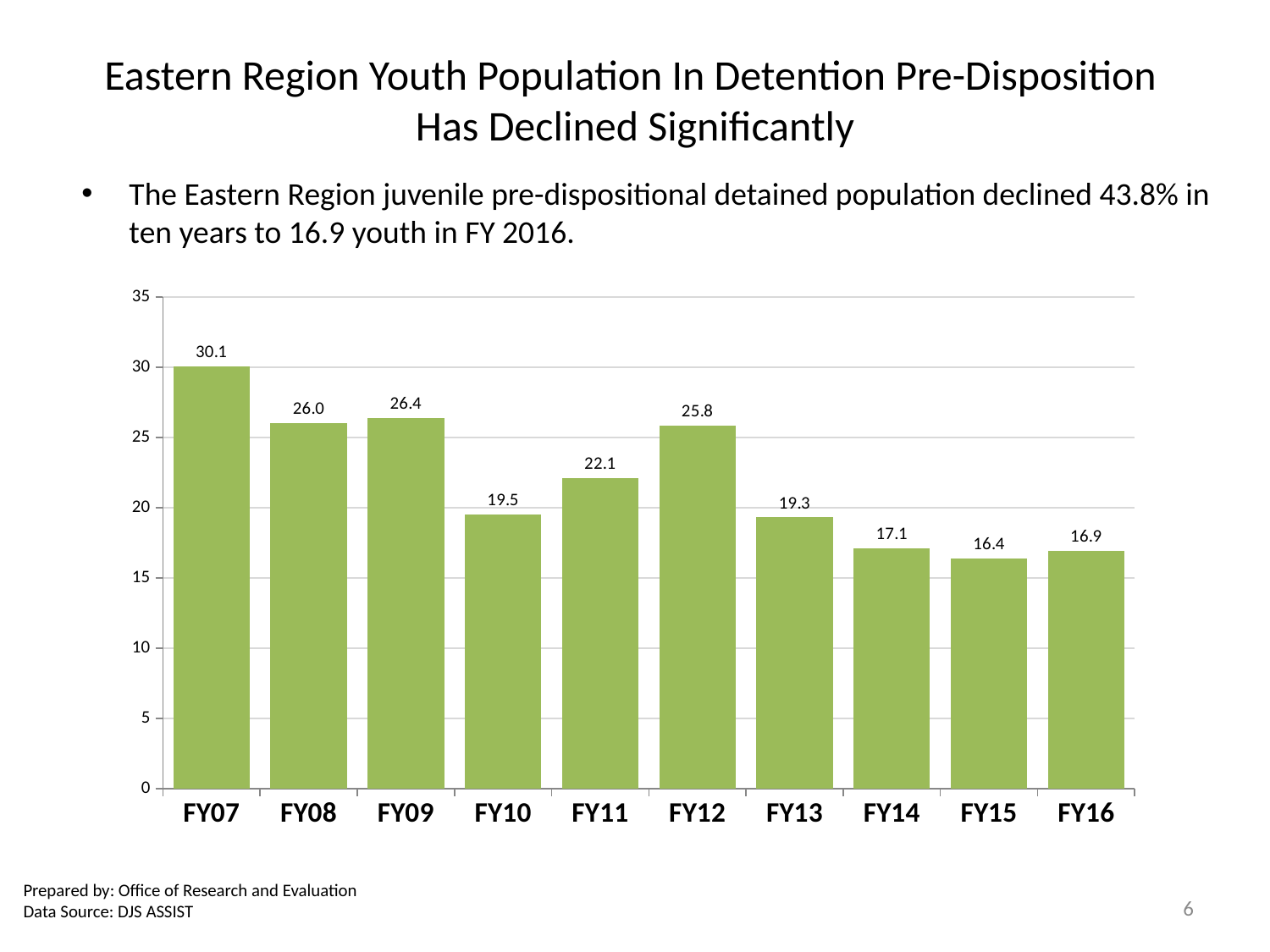
What is the value for FY12? 25.8 Which fiscal year has the lowest value? FY15 Which is larger, the value for FY08 or the value for FY09? FY09 Which fiscal year has the highest value? FY07 What is the value for FY16? 16.9 Is the value for FY11 greater or less than 20? greater What kind of chart is shown on the slide? bar chart How many fiscal years are shown on the x axis? 10 What is the difference between the values for FY07 and FY16? 13.2 What colour are the bars in the chart? green What is the value for FY07? 30.1 Do the values generally rise or fall from FY07 to FY16? fall